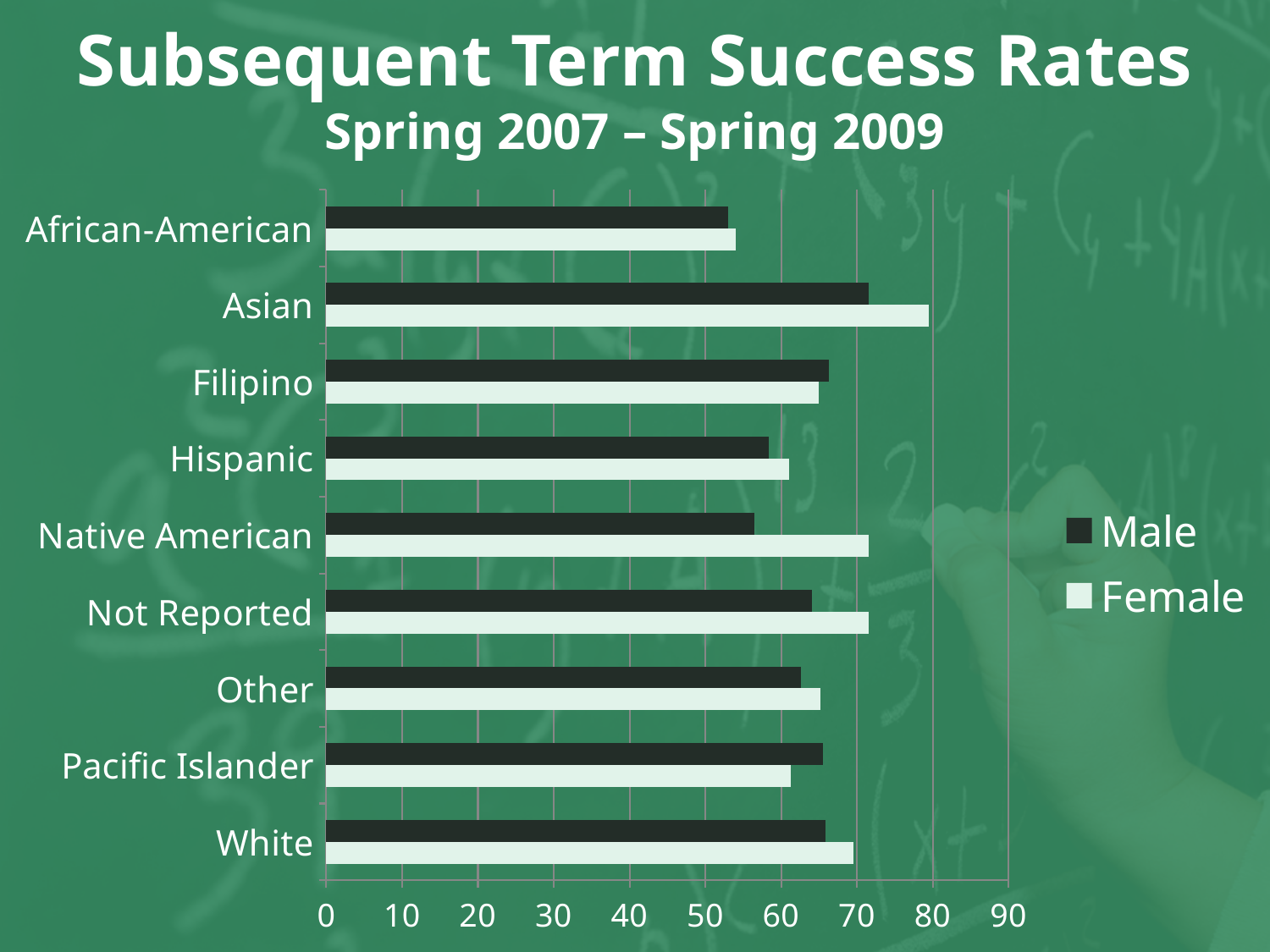
Which category has the lowest Female success rate? African-American For Pacific Islander, which is larger, the Male or the Female value? Male How many ethnic categories are shown on the chart? 9 How many series does the legend list? 2 Is the Female value for Asian greater or less than 70? greater Which category has the lowest Male success rate? African-American Which category has the highest Female success rate? Asian Is the Male value for Native American greater or less than 60? less Is the Male value for African-American greater or less than 60? less What kind of chart is shown on the slide? bar chart What is the title of the chart? Subsequent Term Success Rates Spring 2007 – Spring 2009 For Native American, which is larger, the Male or the Female value? Female